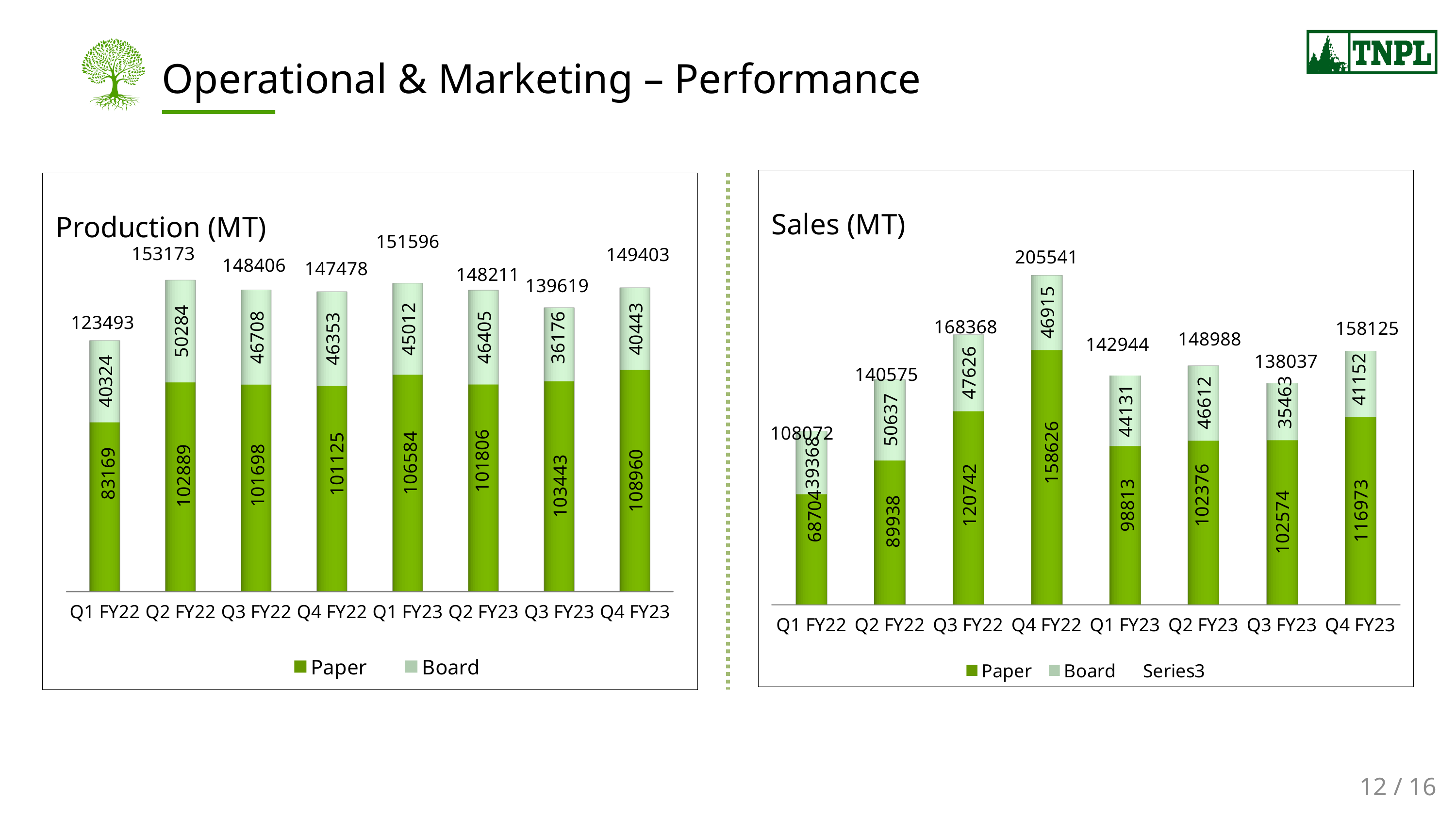
In the Sales (MT) chart, which is larger, the Board value for Q3 FY22 or the Board value for Q3 FY23? Q3 FY22 How many quarters are shown on the x axis of the Sales (MT) chart? 8 In the Production (MT) chart, what is the total of the stacked bar for Q2 FY22? 153173 In the Sales (MT) chart, what is the difference between the total sales for Q4 FY23 and Q3 FY23? 20088 In the Sales (MT) chart, what is the Board value for Q2 FY22? 50637 How many entries does the legend of the Sales (MT) chart list? 3 In the Sales (MT) chart, which quarter has the highest total sales? Q4 FY22 In the Production (MT) chart, which quarter has the lowest total production? Q1 FY22 In the Production (MT) chart, what is the difference between the Paper values for Q4 FY23 and Q1 FY22? 25791 In the Production (MT) chart, what is the Paper value for Q1 FY23? 106584 In the Sales (MT) chart, what is the Paper value for Q4 FY22? 158626 In the Production (MT) chart, what is the Board value for Q3 FY23? 36176